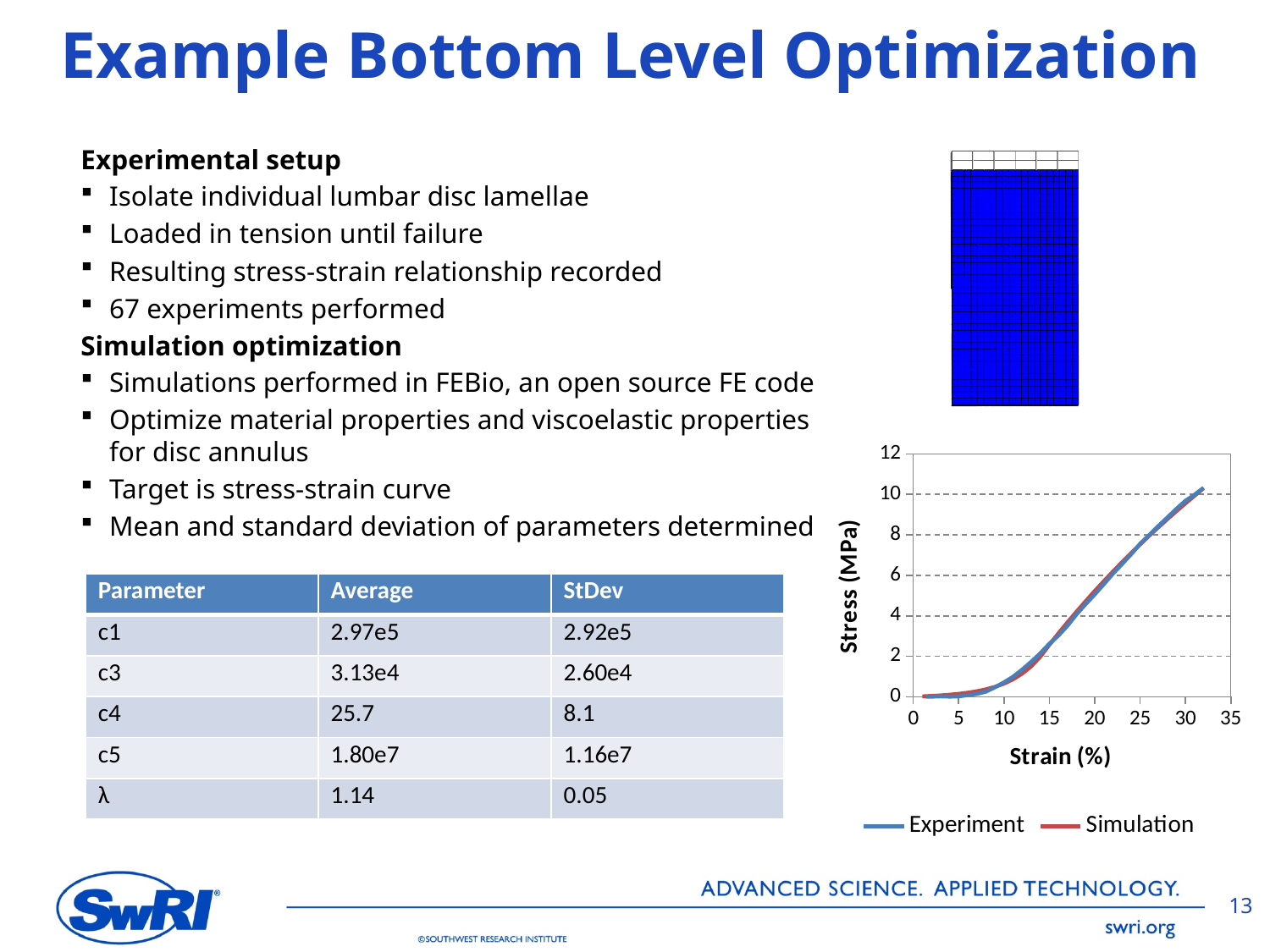
Is the Simulation stress at a strain of 20% greater or less than 4 MPa? greater What kind of chart is shown on the slide? line chart What are the two series named in the chart legend? Experiment and Simulation How many series does the chart's legend list? 2 Does the stress rise or fall as strain increases along the x axis? rise Is the Experiment stress at a strain of 10% greater or less than 2 MPa? less What is the label of the chart's vertical axis? Stress (MPa) Is the Experiment stress at a strain of 25% greater or less than 6 MPa? greater What is the highest value shown on the chart's vertical axis? 12